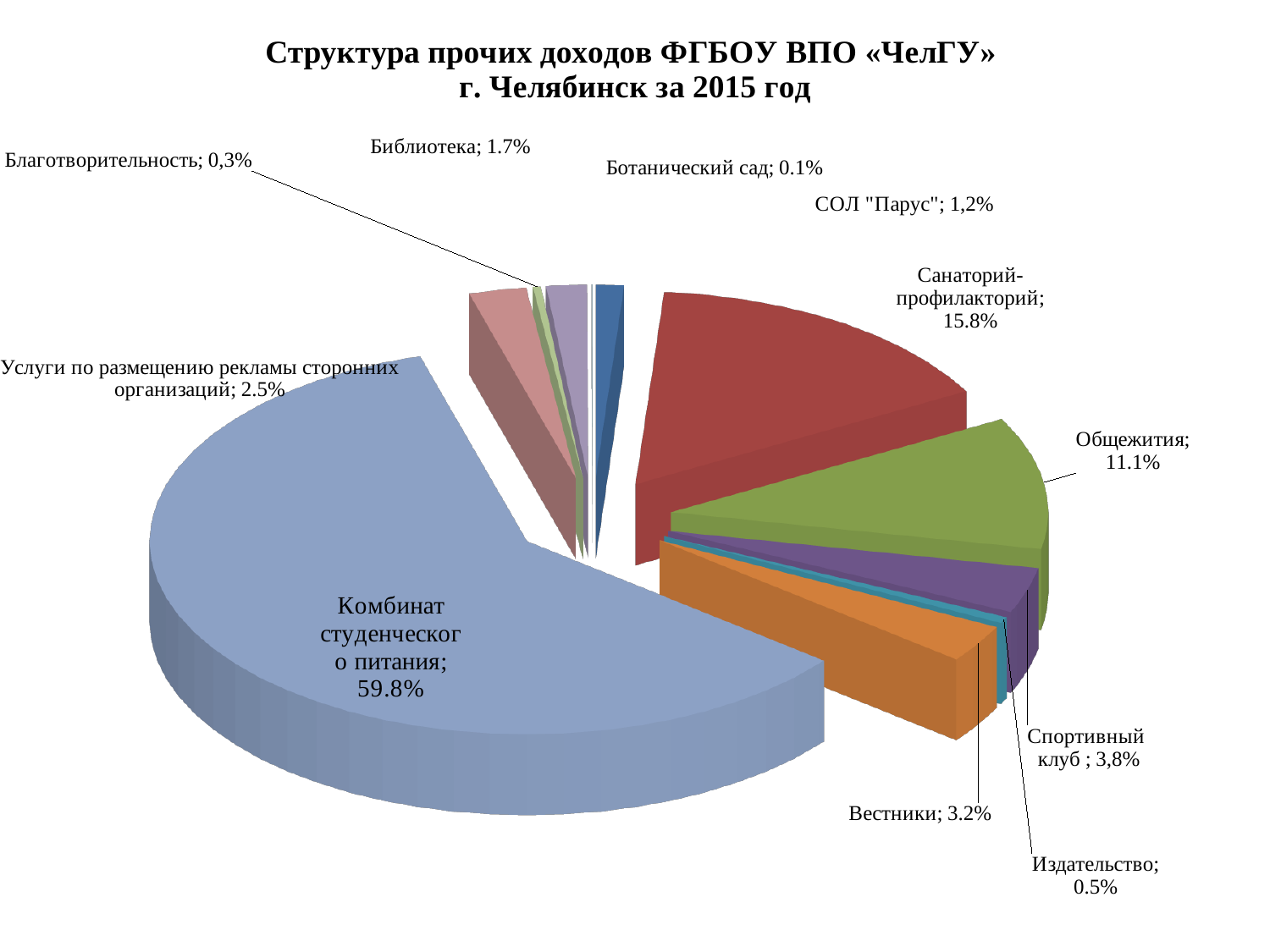
What is the title of the chart? Структура прочих доходов ФГБОУ ВПО «ЧелГУ» г. Челябинск за 2015 год What is the value for Общежития? 11.1% What is the value for Санаторий-профилакторий? 15.8% Which category has the largest share of the pie? Комбинат студенческого питания What is the difference in percentage points between Санаторий-профилакторий and Общежития? 4.7 percentage points What share of the pie does Комбинат студенческого питания have? 59.8% What is the value for Спортивный клуб? 3,8% Which category has the smallest share of the pie? Ботанический сад Which is larger, the share for Вестники or the share for Библиотека? Вестники How many categories (slices) does the pie chart have? 11 What kind of chart is shown on the slide? Pie chart What is the value for Ботанический сад? 0.1%